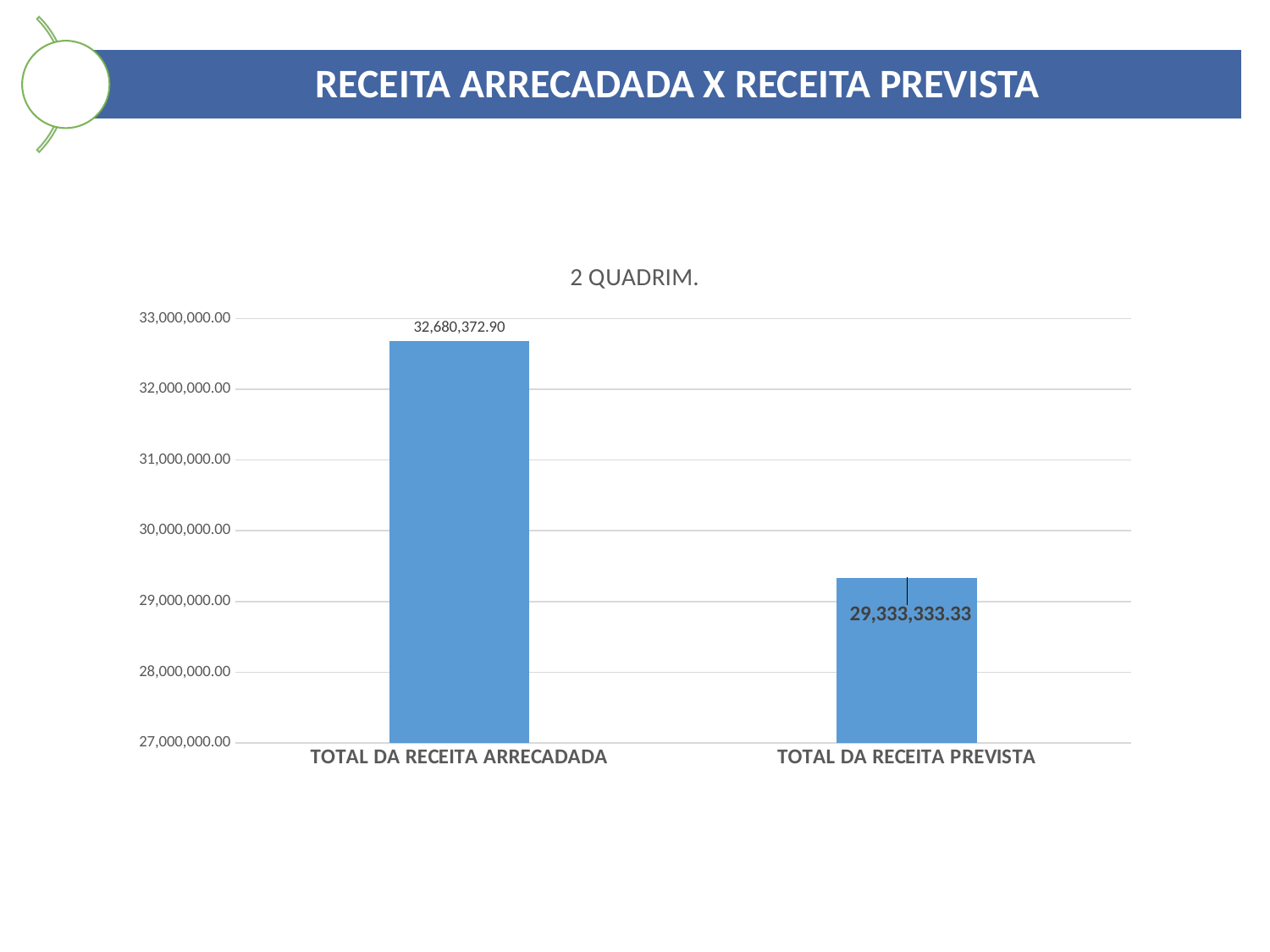
Is the value for TOTAL DA RECEITA PREVISTA greater or less than 30,000,000.00? less What is the difference between TOTAL DA RECEITA ARRECADADA and TOTAL DA RECEITA PREVISTA? 3,347,039.57 What is the lowest value shown on the vertical axis? 27,000,000.00 Which category has the lowest value? TOTAL DA RECEITA PREVISTA What is the value for TOTAL DA RECEITA ARRECADADA? 32,680,372.90 What is the title of the chart? 2 QUADRIM. What kind of chart is shown on the slide? bar chart Is the value for TOTAL DA RECEITA ARRECADADA greater or less than 32,000,000.00? greater Which is larger, TOTAL DA RECEITA ARRECADADA or TOTAL DA RECEITA PREVISTA? TOTAL DA RECEITA ARRECADADA What is the value for TOTAL DA RECEITA PREVISTA? 29,333,333.33 Which category has the highest value? TOTAL DA RECEITA ARRECADADA How many categories are shown in the chart? 2